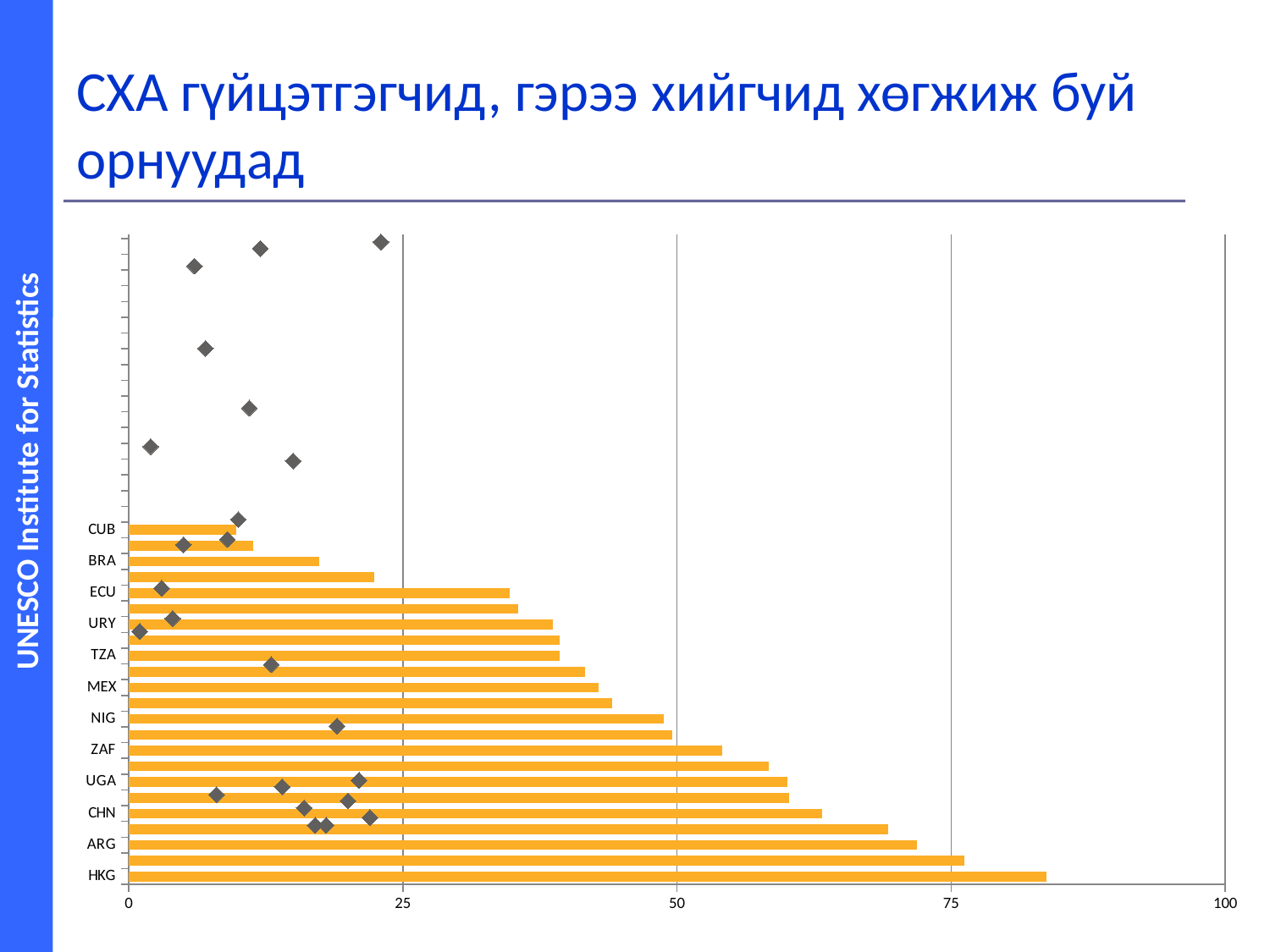
Which labelled category has the longest bar? HKG Is the bar for BRA greater or less than 25? less Is the bar for URY greater or less than 25? greater Is the bar for CHN greater or less than 50? greater Which has the longer bar, ARG or BRA? ARG What kind of chart is shown on the slide? bar chart What is the highest value shown on the horizontal axis? 100 Which labelled category has the shortest bar? CUB